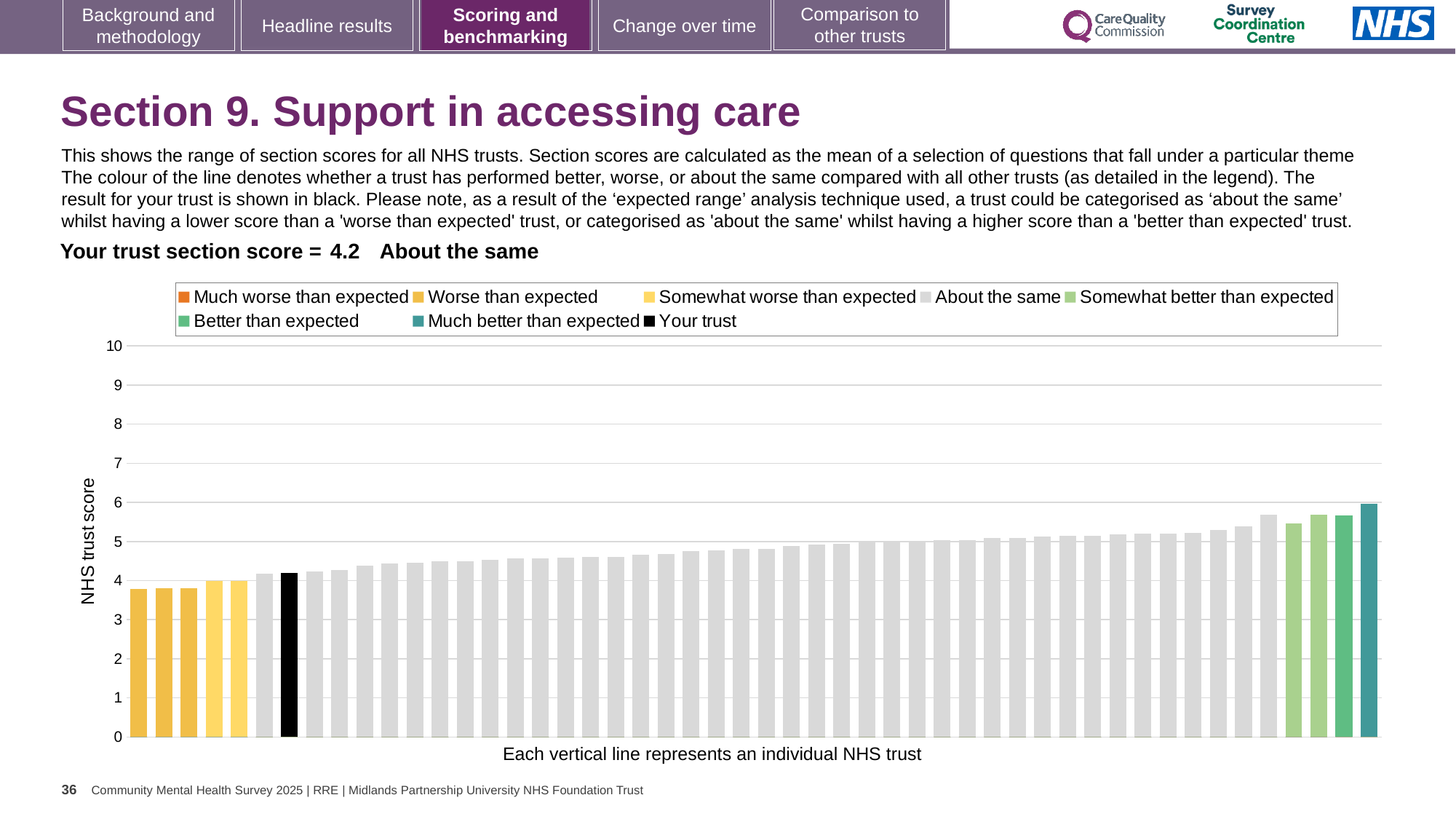
Which is larger: the value of the black 'Your trust' bar or the value of the rightmost bar? The rightmost bar Is the value of the tallest bar (the rightmost bar) greater or less than 5? greater How many entries does the chart legend list? 8 What is the label on the y axis of the chart? NHS trust score Which category is your trust placed in for this section? About the same According to the legend, which category does the colour of the rightmost bar represent? Much better than expected Is the value of the tallest bar greater or less than 7? less What is the section score for your trust shown on the slide? 4.2 Do the bar values rise or fall from left to right along the x axis? Rise Is the value of the leftmost bar greater or less than 5? less What kind of chart is shown on the slide? Bar chart